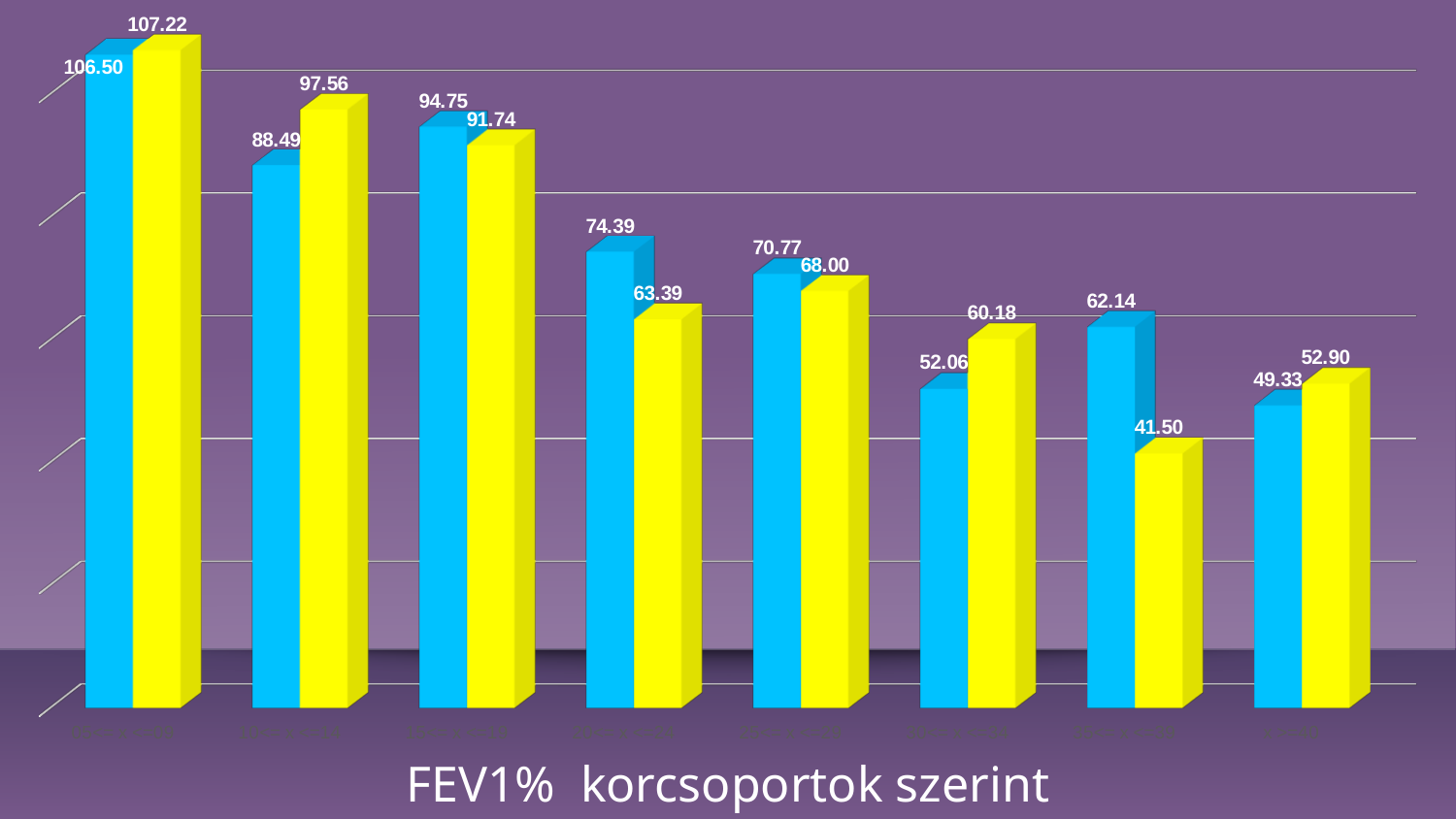
What is the value of the yellow bar in the seventh group from the left? 41.50 What is the highest value among the yellow bars? 107.22 What is the title of the chart? FEV1% korcsoportok szerint How many category groups are plotted along the x axis? 8 What kind of chart is shown on the slide? bar chart How many bars are there in each category group? 2 Do the blue bar values generally rise or fall from left to right across the groups? fall In the seventh group from the left, how much larger is the blue bar than the yellow bar? 20.64 What is the value of the yellow bar in the second group from the left? 97.56 What is the value of the blue bar in the first (leftmost) group? 106.50 In the third group from the left, which bar is larger, the blue or the yellow one? blue What is the lowest value among the blue bars? 49.33